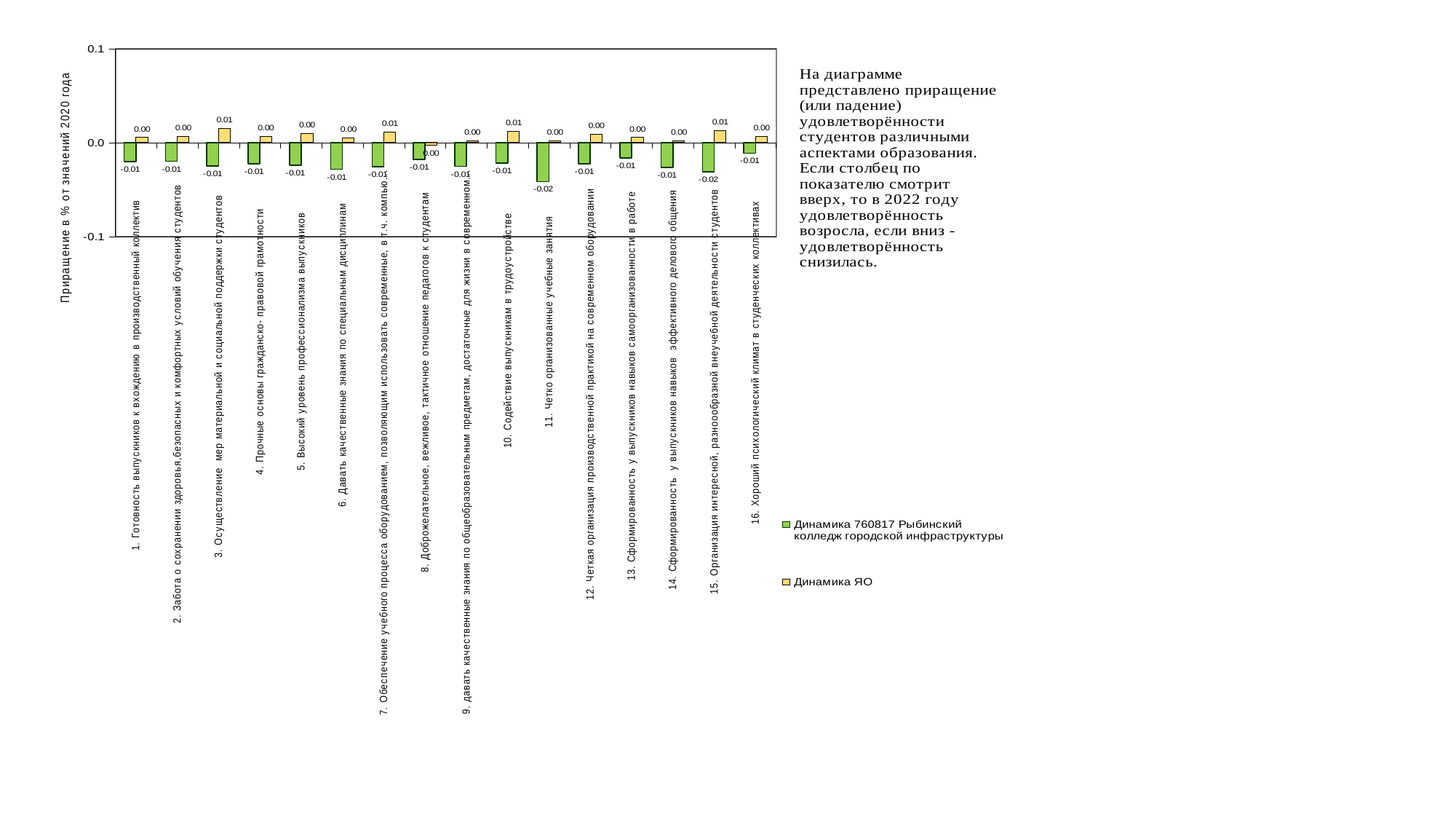
What is the value of the 'Динамика 760817 Рыбинский колледж городской инфраструктуры' series for category '11. Четко организованные учебные занятия'? -0.02 What is the title of the vertical axis of the chart? Приращение в % от значений 2020 года What is the value of the 'Динамика ЯО' series for category '10. Содействие выпускникам в трудоустройстве'? 0.01 How many categories are shown on the x axis of the chart? 16 What is the value of the 'Динамика ЯО' series for category '3. Осуществление мер материальной и социальной поддержки студентов'? 0.01 What kind of chart is shown on the slide? Bar chart For category '11. Четко организованные учебные занятия', which series has the larger value: 'Динамика 760817 Рыбинский колледж городской инфраструктуры' or 'Динамика ЯО'? Динамика ЯО What is the value of the 'Динамика 760817 Рыбинский колледж городской инфраструктуры' series for category '1. Готовность выпускников к вхождению в производственный коллектив'? -0.01 What is the value of the 'Динамика ЯО' series for category '16. Хороший психологический климат в студенческих коллективах'? 0.00 How many series does the chart legend list? 2 What is the value of the 'Динамика 760817 Рыбинский колледж городской инфраструктуры' series for category '15. Организация интересной, разнообразной внеучебной деятельности студентов'? -0.02 What is the difference between the 'Динамика ЯО' value and the 'Динамика 760817 Рыбинский колледж городской инфраструктуры' value for category '11. Четко организованные учебные занятия'? 0.02